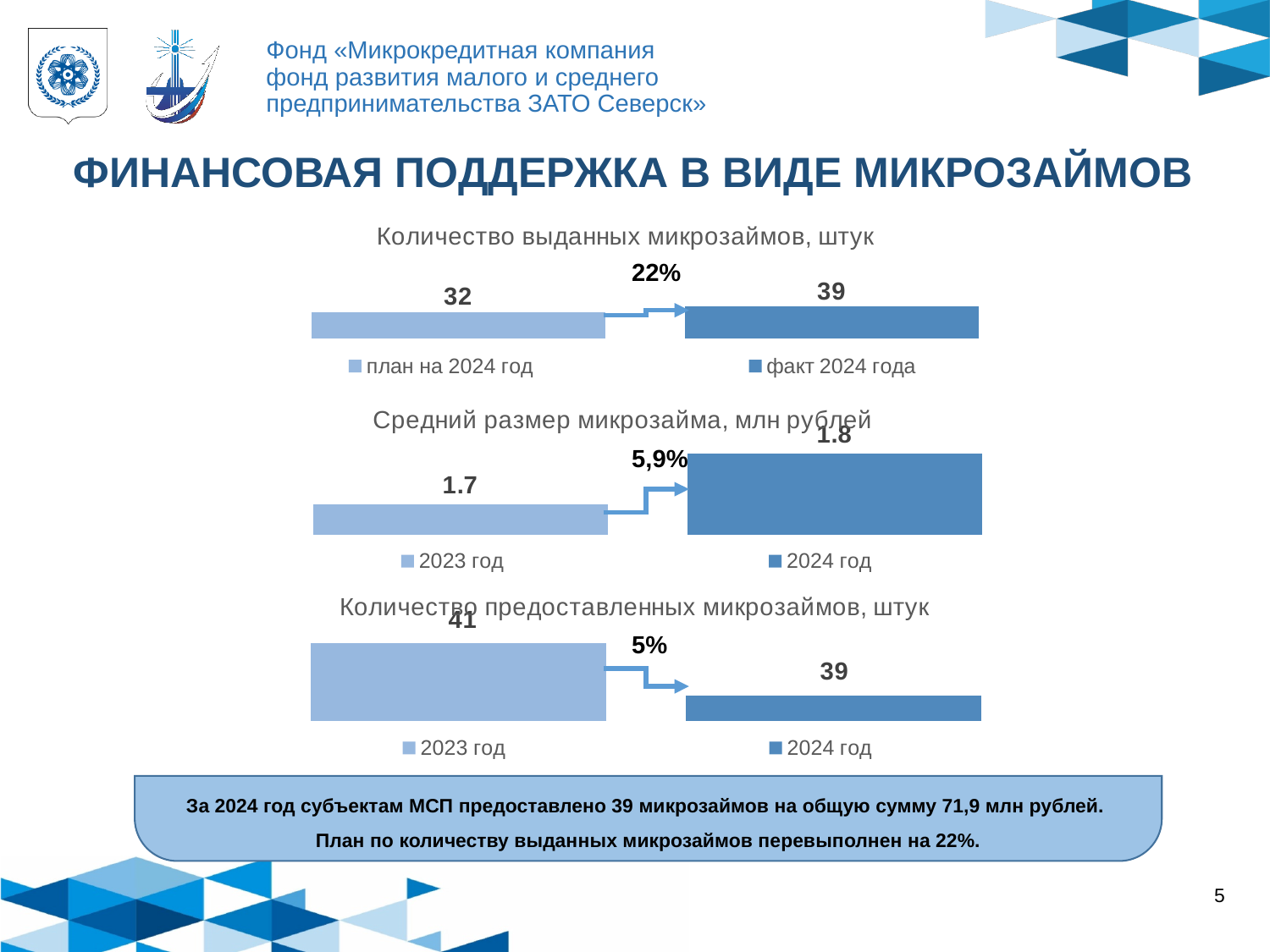
In the chart 'Количество выданных микрозаймов, штук', which is larger: 'план на 2024 год' or 'факт 2024 года'? факт 2024 года In the chart 'Количество выданных микрозаймов, штук', what is the value for 'факт 2024 года'? 39 In the chart 'Средний размер микрозайма, млн рублей', what percentage change is shown on the arrow between the two bars? 5,9% In the chart 'Количество предоставленных микрозаймов, штук', what is the value for '2024 год'? 39 In the chart 'Количество выданных микрозаймов, штук', what is the value for 'план на 2024 год'? 32 In the chart 'Количество выданных микрозаймов, штук', what is the difference between 'факт 2024 года' and 'план на 2024 год'? 7 In the chart 'Количество предоставленных микрозаймов, штук', what is the difference between the 2023 and 2024 values? 2 In the chart 'Количество предоставленных микрозаймов, штук', which year has the higher value? 2023 год What type of chart is 'Количество выданных микрозаймов, штук'? bar chart In the chart 'Средний размер микрозайма, млн рублей', what is the value for '2023 год'? 1.7 In the chart 'Средний размер микрозайма, млн рублей', what is the value for '2024 год'? 1.8 In the chart 'Количество предоставленных микрозаймов, штук', what is the value for '2023 год'? 41